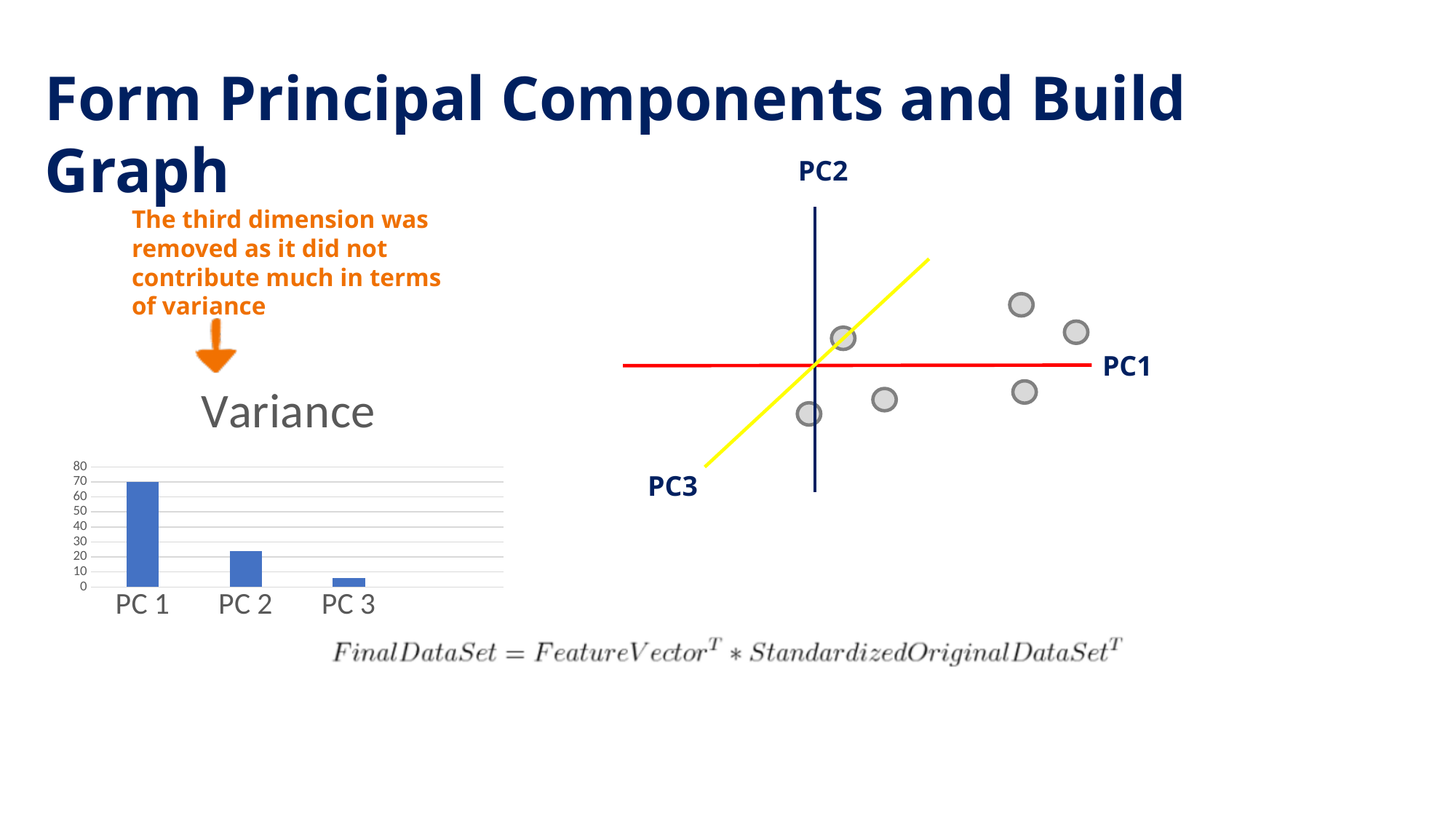
What kind of chart is the Variance chart? bar chart In the Variance chart, which is larger, the value for PC 2 or the value for PC 3? PC 2 In the Variance chart, is the value for PC 1 greater or less than 60? greater How many categories are shown on the x axis of the Variance chart? 3 Which category has the lowest value in the Variance chart? PC 3 What is the highest tick value shown on the y axis of the Variance chart? 80 In the Variance chart, which is larger, the value for PC 1 or the value for PC 2? PC 1 Do the values in the Variance chart rise or fall from PC 1 to PC 3? fall What is the title of the bar chart on the slide? Variance In the Variance chart, is the value for PC 2 greater or less than 30? less Which category has the highest value in the Variance chart? PC 1 In the Variance chart, is the value for PC 3 greater or less than 10? less